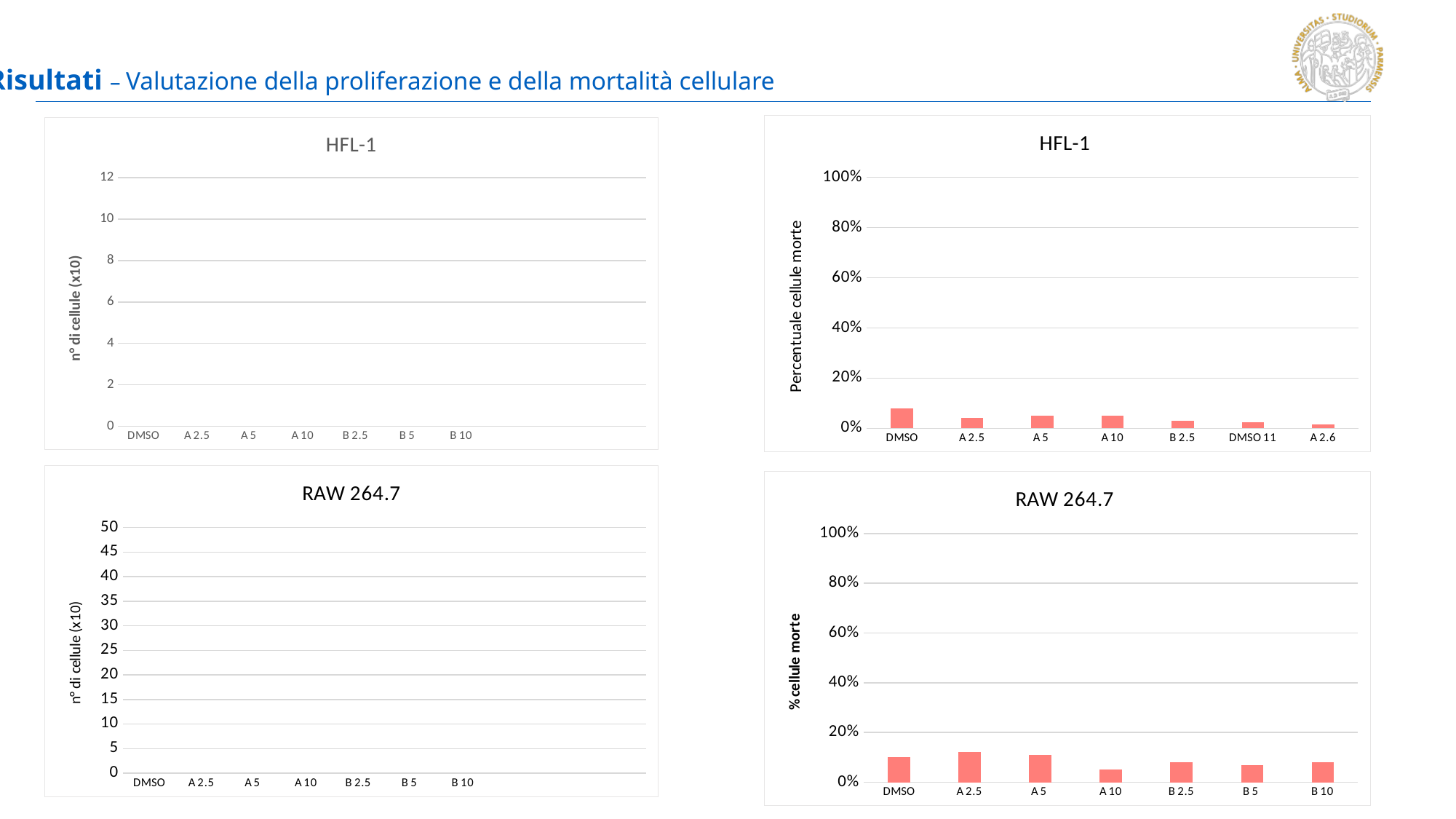
In the top-right HFL-1 chart, which is larger, the value for DMSO or the value for A 2.5? DMSO In the bottom-right RAW 264.7 chart, which category has the lowest percentage of dead cells? A 10 What kind of chart is the top-right chart titled HFL-1? bar chart How many categories are shown on the x axis of the top-right HFL-1 chart? 7 In the bottom-right RAW 264.7 chart, is the value for A 2.5 greater or less than 20%? less In the bottom-right RAW 264.7 chart, which category has the highest percentage of dead cells? A 2.5 In the top-right HFL-1 chart, which category has the highest percentage of dead cells? DMSO In the bottom-right RAW 264.7 chart, which is larger, the value for A 5 or the value for A 10? A 5 How many categories are shown on the x axis of the bottom-left RAW 264.7 chart? 7 What is the y-axis title of the bottom-right RAW 264.7 chart? % cellule morte In the top-right HFL-1 chart, is the value for DMSO greater or less than 20%? less What is the y-axis title of the top-right HFL-1 chart? Percentuale cellule morte